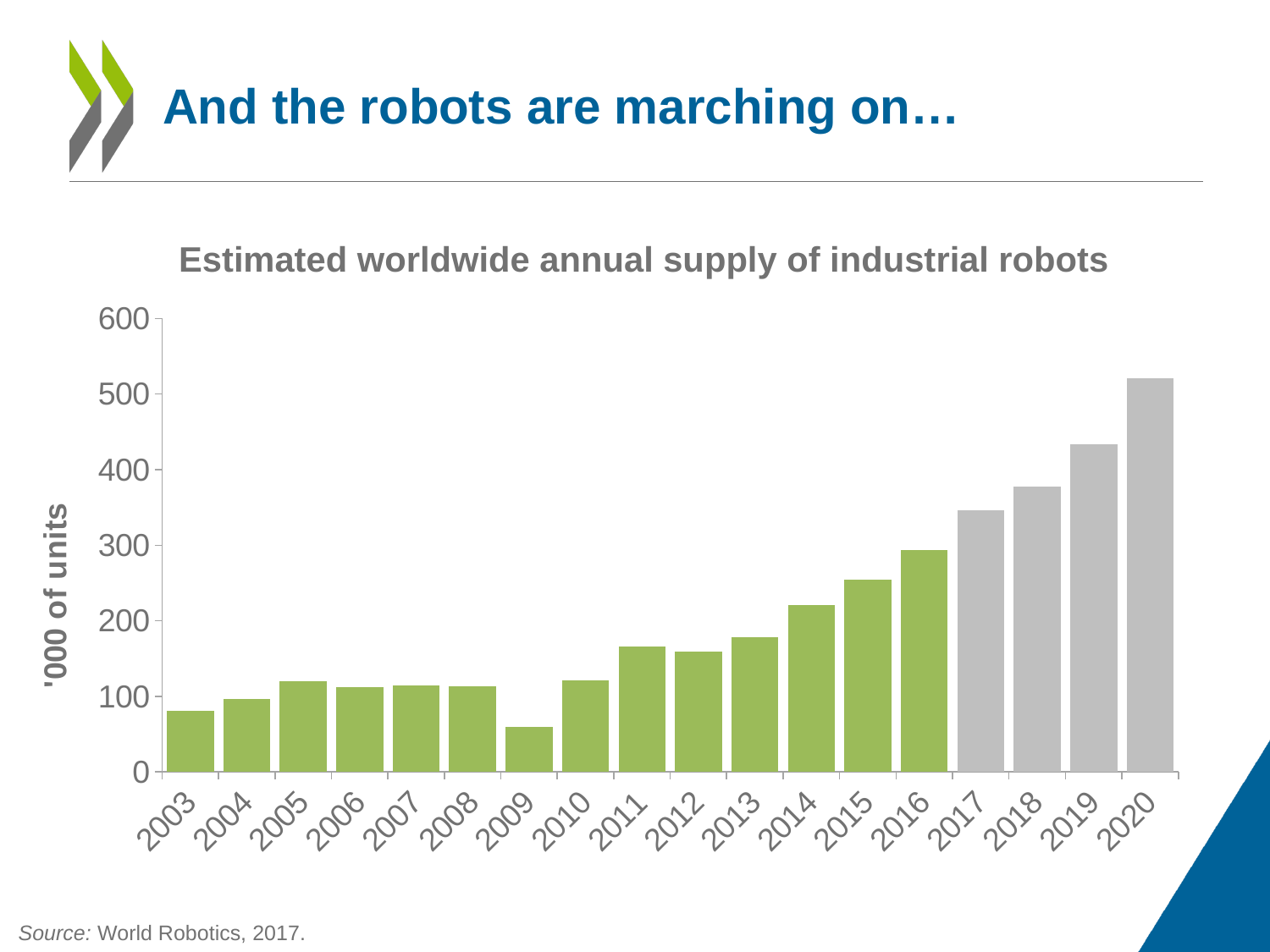
Is the value for 2014 greater or less than 200? greater Is the value for 2019 greater or less than 400? greater Is the value for 2009 greater or less than 100? less What is the title of the chart? Estimated worldwide annual supply of industrial robots What is the label on the vertical axis of the chart? '000 of units What type of chart is shown on the slide? Bar chart Which year has the larger value, 2010 or 2015? 2015 Overall, do the values rise or fall from 2010 to 2020? Rise How many years are shown on the x axis of the chart? 18 Which year has the lowest bar in the chart? 2009 Which year has the highest bar in the chart? 2020